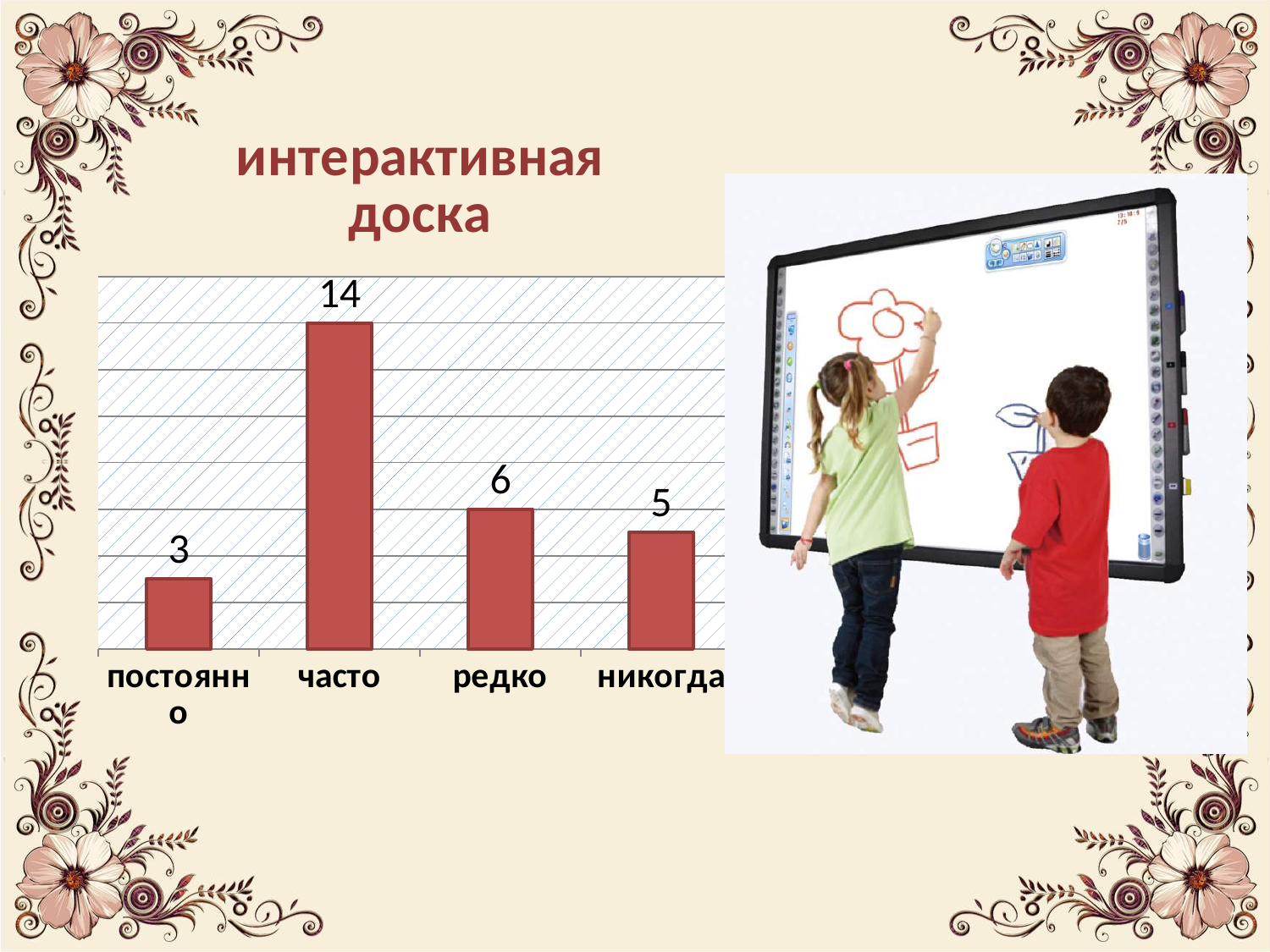
What is the difference between the values for "часто" and "редко"? 8 What kind of chart is shown on the slide? bar chart What is the value for "часто"? 14 Which is larger, the value for "редко" or the value for "никогда"? редко Which category has the lowest value? постоянно What is the difference between the values for "никогда" and "постоянно"? 2 What is the value for "никогда"? 5 What is the title of the chart? интерактивная доска How many categories are shown on the x axis? 4 What is the value for "постоянно"? 3 What is the value for "редко"? 6 Which category has the highest value? часто